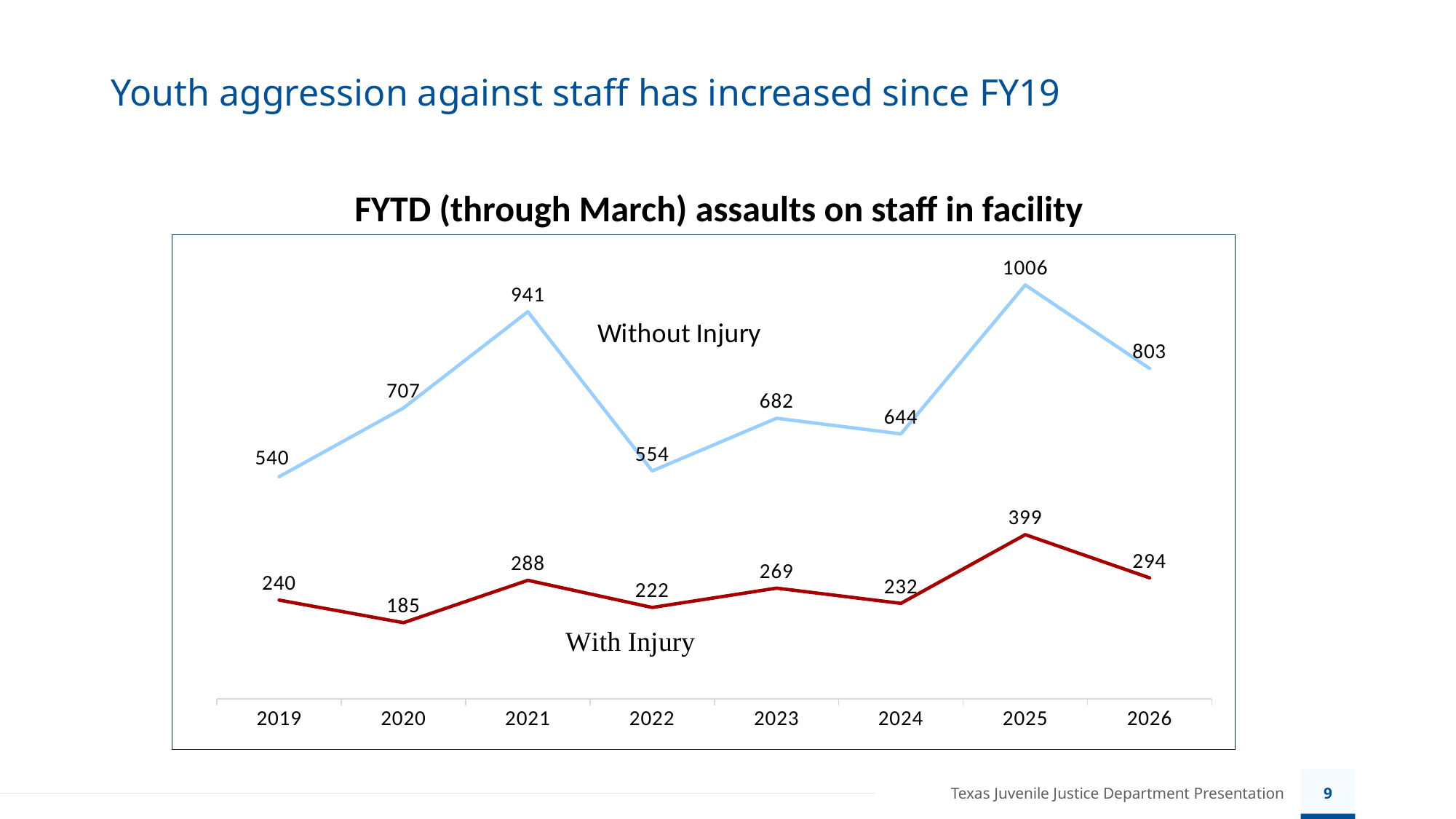
In which year is the Without Injury series highest? 2025 What kind of chart is shown? Line chart How much did the With Injury value change from 2024 to 2025? 167 In which year is the With Injury series lowest? 2020 What is the title of the chart? FYTD (through March) assaults on staff in facility What is the Without Injury value for 2021? 941 Which is larger, the Without Injury value in 2022 or in 2023? 2023 How many series are plotted on the chart? 2 How many years are shown on the x axis? 8 What is the Without Injury value for 2026? 803 What is the With Injury value for 2020? 185 What is the difference between the Without Injury and With Injury values in 2025? 607